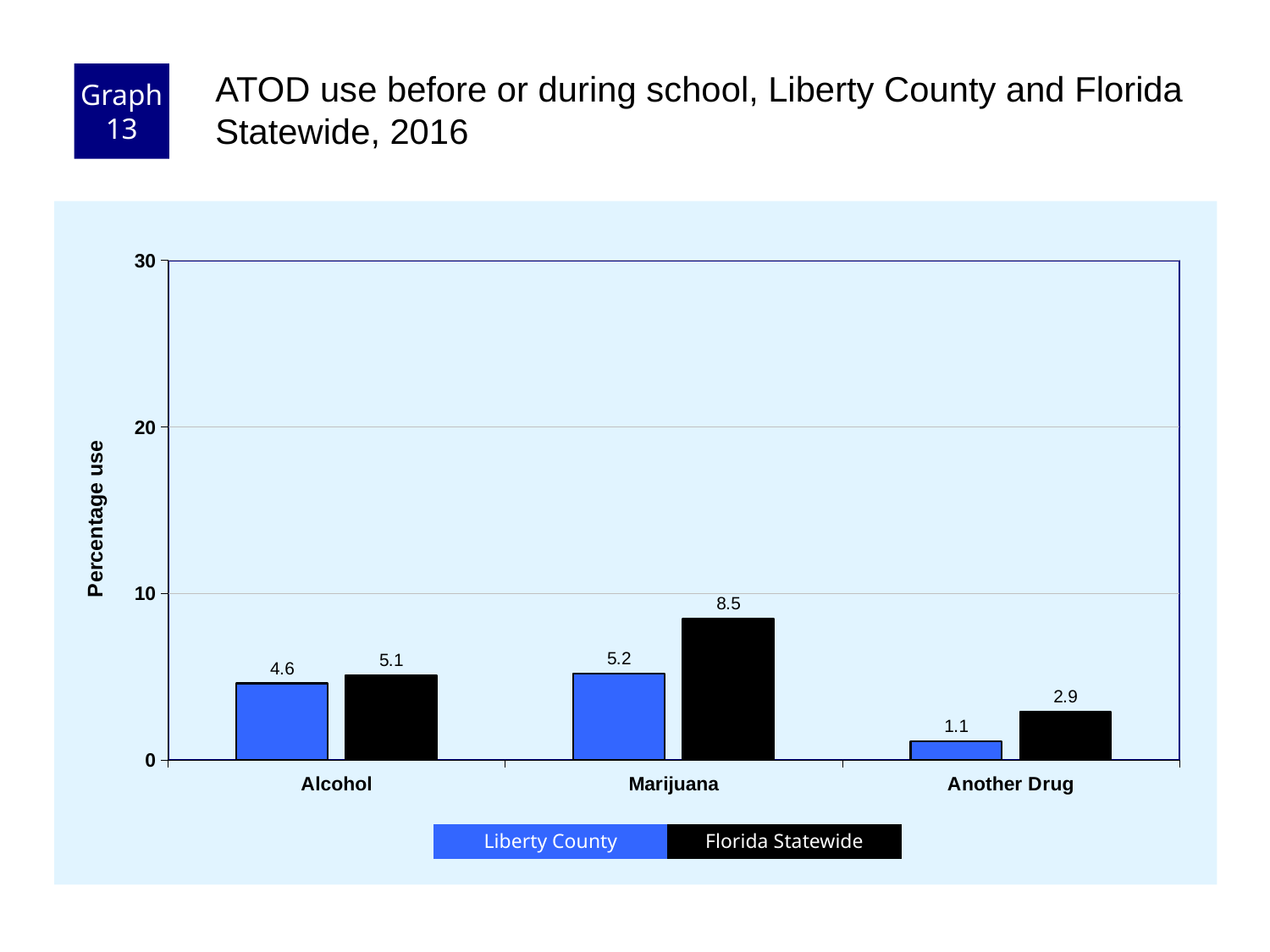
Which category has the lowest Liberty County value? Another Drug How many categories are shown on the x axis? 3 What is the Florida Statewide value for Another Drug? 2.9 What kind of chart is shown on the slide? bar chart Which is larger for Alcohol, the Liberty County value or the Florida Statewide value? Florida Statewide What is the Florida Statewide value for Marijuana? 8.5 Is the Florida Statewide value for Marijuana greater or less than 10? less Which category has the highest Florida Statewide value? Marijuana What is the Liberty County value for Alcohol? 4.6 What is the difference between the Florida Statewide and Liberty County values for Marijuana? 3.3 How many series does the legend list? 2 What is the Liberty County value for Another Drug? 1.1